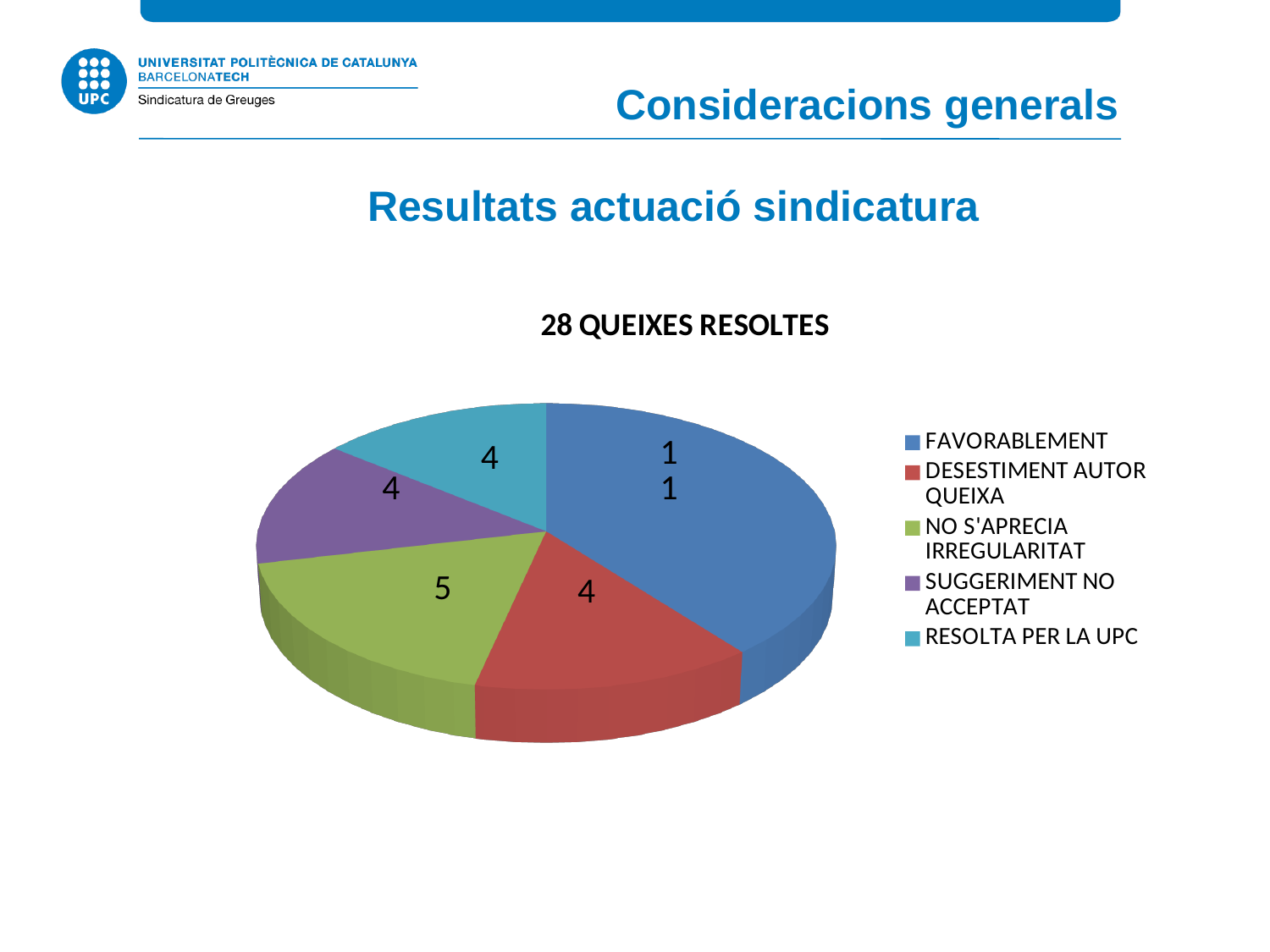
Which is larger, the value for NO S'APRECIA IRREGULARITAT or the value for SUGGERIMENT NO ACCEPTAT? NO S'APRECIA IRREGULARITAT What is the value for FAVORABLEMENT in the pie chart? 11 What is the value for RESOLTA PER LA UPC in the pie chart? 4 What is the difference between the values for FAVORABLEMENT and NO S'APRECIA IRREGULARITAT? 6 What type of chart is shown on the slide? pie chart What is the total of all the slices in the pie chart? 28 What is the value for NO S'APRECIA IRREGULARITAT in the pie chart? 5 How many categories does the pie chart have? 5 What is the value for DESESTIMENT AUTOR QUEIXA in the pie chart? 4 How many entries does the legend list? 5 Which category has the largest slice in the pie chart? FAVORABLEMENT What is the title of the pie chart? 28 QUEIXES RESOLTES